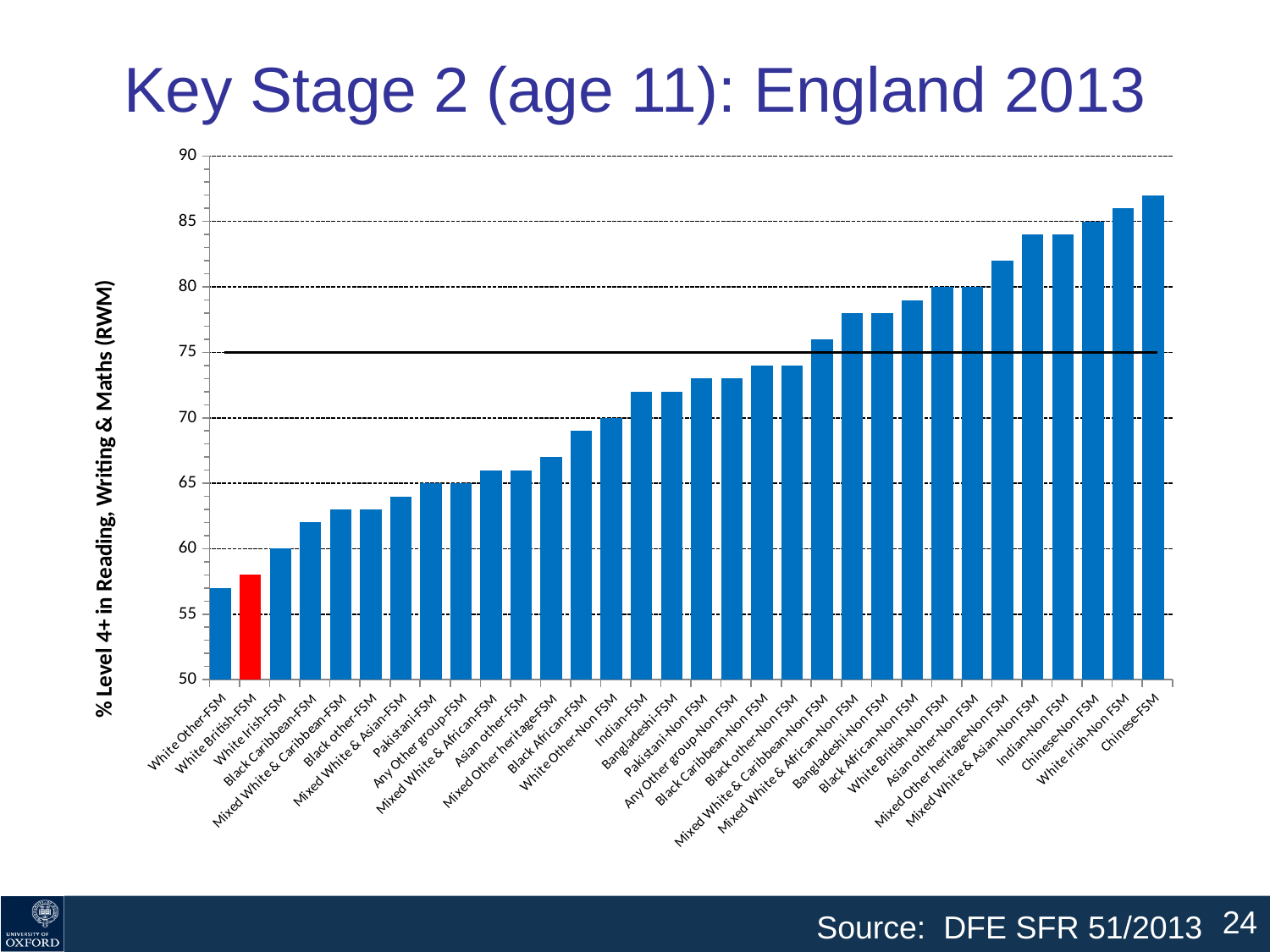
What is the label on the vertical axis? % Level 4+ in Reading, Writing & Maths (RWM) Is the value for White British-FSM greater or less than 60? less Which category has the highest value? Chinese-FSM Which category has the lowest value? White Other-FSM Is the value for Black Caribbean-Non FSM greater or less than 75? less How many bars (categories) are plotted on the chart? 32 Is the value for Chinese-FSM greater or less than 85? greater Which category is shown with a red bar? White British-FSM Which is larger, the value for Chinese-Non FSM or the value for Pakistani-FSM? Chinese-Non FSM Do the values rise or fall moving from left to right along the x axis? rise What kind of chart is shown on the slide? bar chart